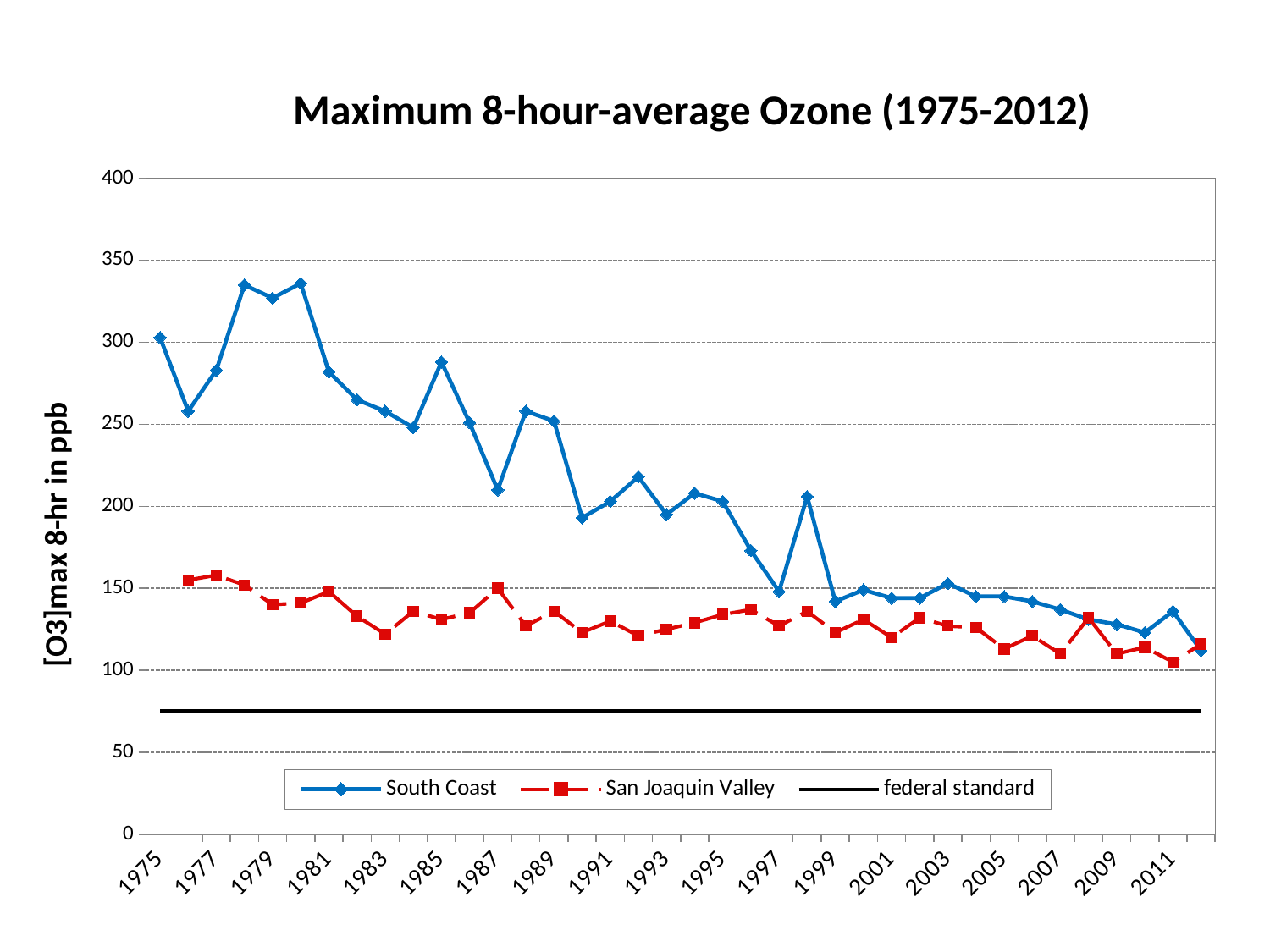
Does the South Coast series generally rise or fall from 1975 to 2012? fall Is the South Coast value for 1980 greater or less than 300? greater Is the federal standard line greater or less than 100? less What type of chart is shown on the slide? line chart In 1990, which series has the higher value, South Coast or San Joaquin Valley? South Coast Is the South Coast value for 2012 greater or less than 150? less What is the title of the chart? Maximum 8-hour-average Ozone (1975-2012) In 1979, which series has the higher value, South Coast or San Joaquin Valley? South Coast What is the label of the y axis? [O3]max 8-hr in ppb How many series does the legend list? 3